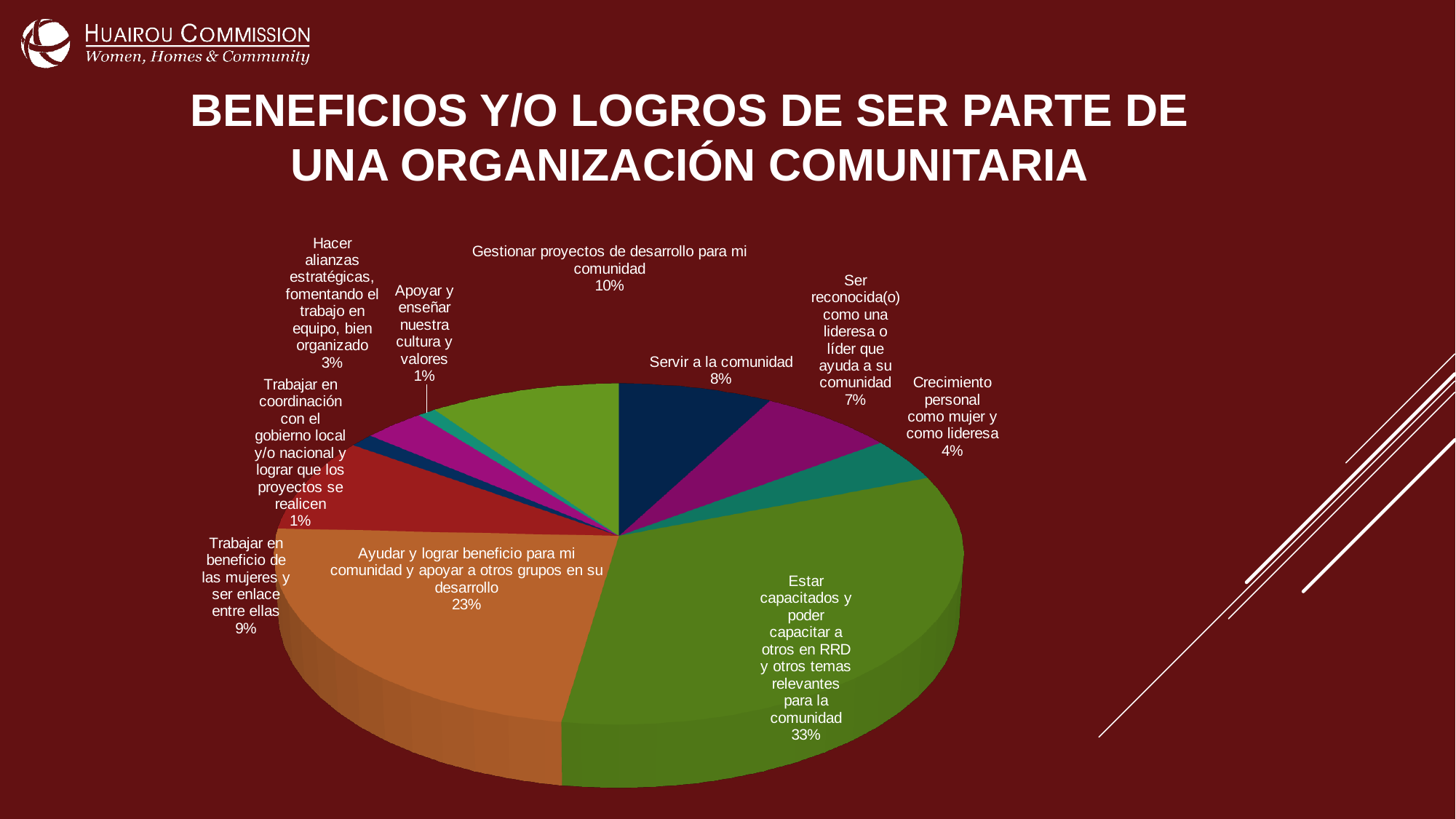
Which is larger: the share for "Trabajar en beneficio de las mujeres y ser enlace entre ellas" or the share for "Servir a la comunidad"? Trabajar en beneficio de las mujeres y ser enlace entre ellas What percentage is shown for "Hacer alianzas estratégicas, fomentando el trabajo en equipo, bien organizado"? 3% What percentage is shown for "Gestionar proyectos de desarrollo para mi comunidad"? 10% Which category has the largest share of the pie? Estar capacitados y poder capacitar a otros en RRD y otros temas relevantes para la comunidad What percentage is shown for "Ayudar y lograr beneficio para mi comunidad y apoyar a otros grupos en su desarrollo"? 23% What percentage is shown for "Servir a la comunidad"? 8% How many slices does the pie chart have? 10 What is the difference in percentage points between "Estar capacitados y poder capacitar a otros en RRD y otros temas relevantes para la comunidad" and "Ayudar y lograr beneficio para mi comunidad y apoyar a otros grupos en su desarrollo"? 10 percentage points What percentage is shown for "Crecimiento personal como mujer y como lideresa"? 4% What kind of chart is shown on the slide? Pie chart What is the title of the slide? BENEFICIOS Y/O LOGROS DE SER PARTE DE UNA ORGANIZACIÓN COMUNITARIA What percentage is shown for "Estar capacitados y poder capacitar a otros en RRD y otros temas relevantes para la comunidad"? 33%